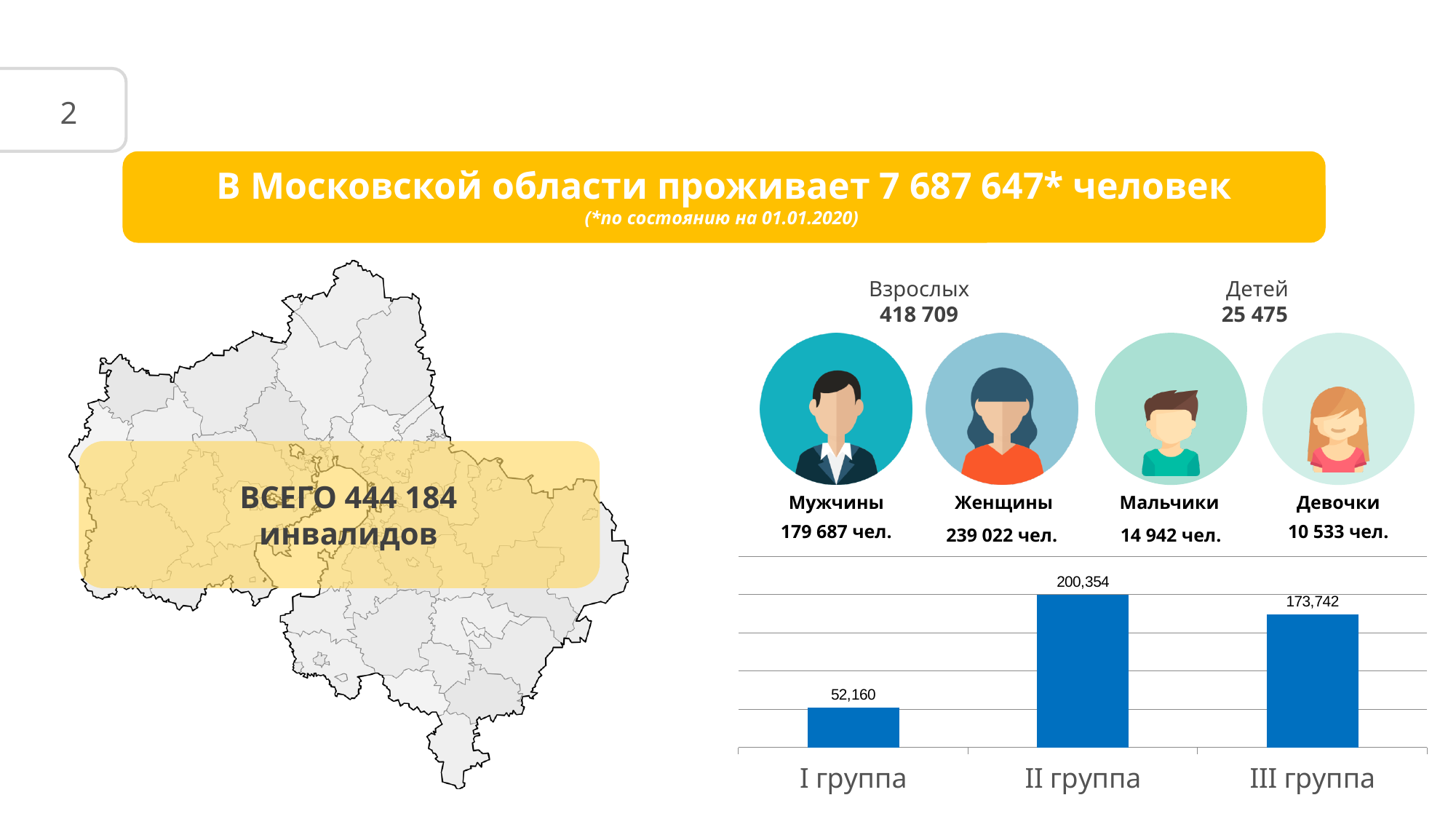
What kind of chart is shown at the bottom right of the slide? Bar chart What colour are the bars in the bar chart? Blue What is the difference between the values for II группа and I группа in the bar chart? 148,194 Which category has the lowest value in the bar chart? I группа Does the value rise or fall from II группа to III группа in the bar chart? Fall What is the difference between the values for II группа and III группа in the bar chart? 26,612 How many categories are shown in the bar chart? 3 Which category has the highest value in the bar chart? II группа What is the value for II группа in the bar chart? 200,354 Which is larger in the bar chart, the value for III группа or the value for I группа? III группа What is the value for III группа in the bar chart? 173,742 What is the value for I группа in the bar chart? 52,160